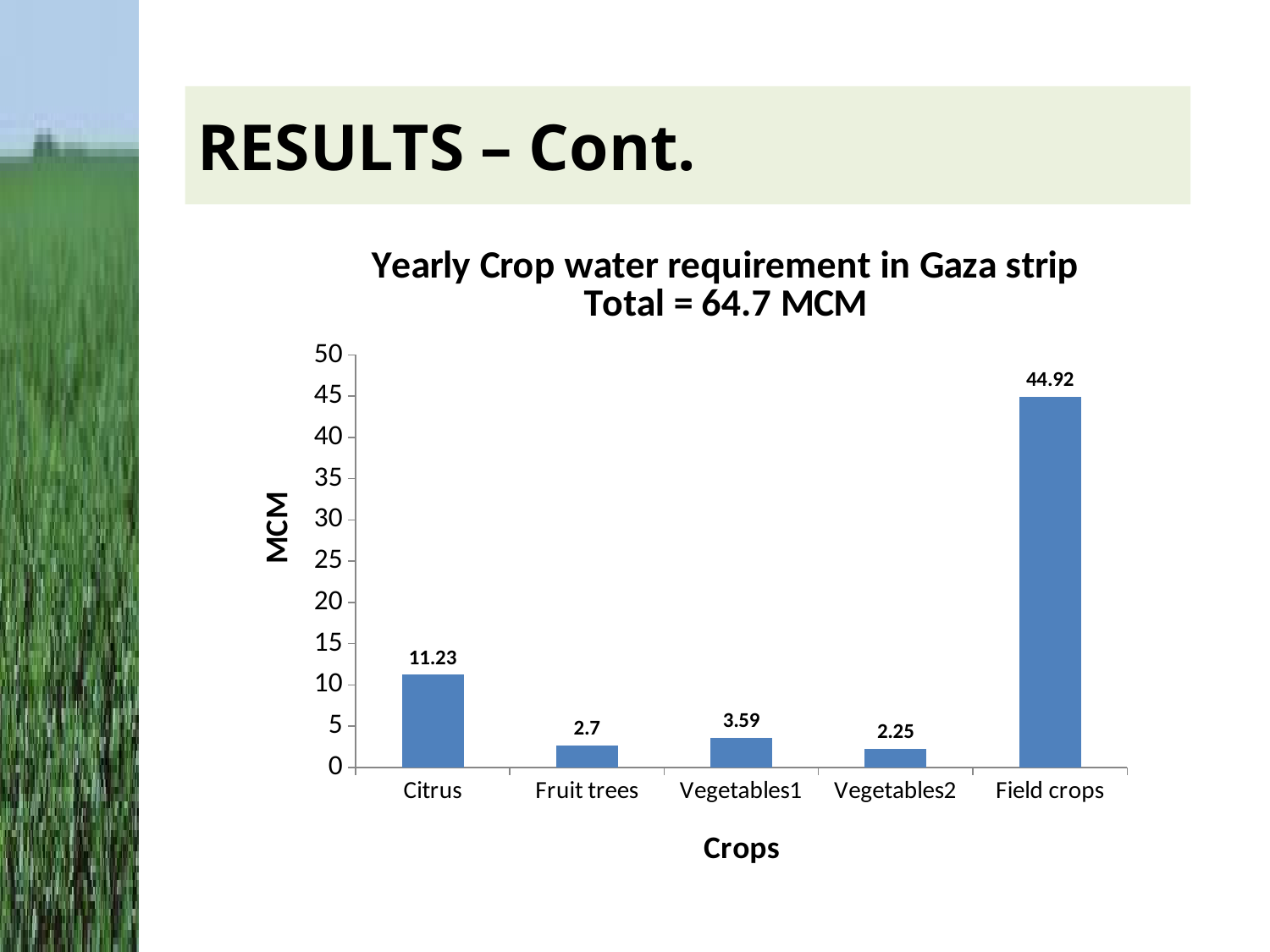
Which crop has the lowest water requirement? Vegetables2 How many crop categories are shown on the x axis? 5 What is the value shown for Fruit trees? 2.7 Which has a larger value, Vegetables1 or Vegetables2? Vegetables1 Is the value for Citrus greater or less than 10? greater Which crop has the highest water requirement? Field crops What is the label of the y axis? MCM What is the value shown for Field crops? 44.92 What is the yearly crop water requirement for Citrus? 11.23 What kind of chart is shown on the slide? Bar chart What is the difference between the values for Field crops and Citrus? 33.69 What is the value shown for Vegetables1? 3.59